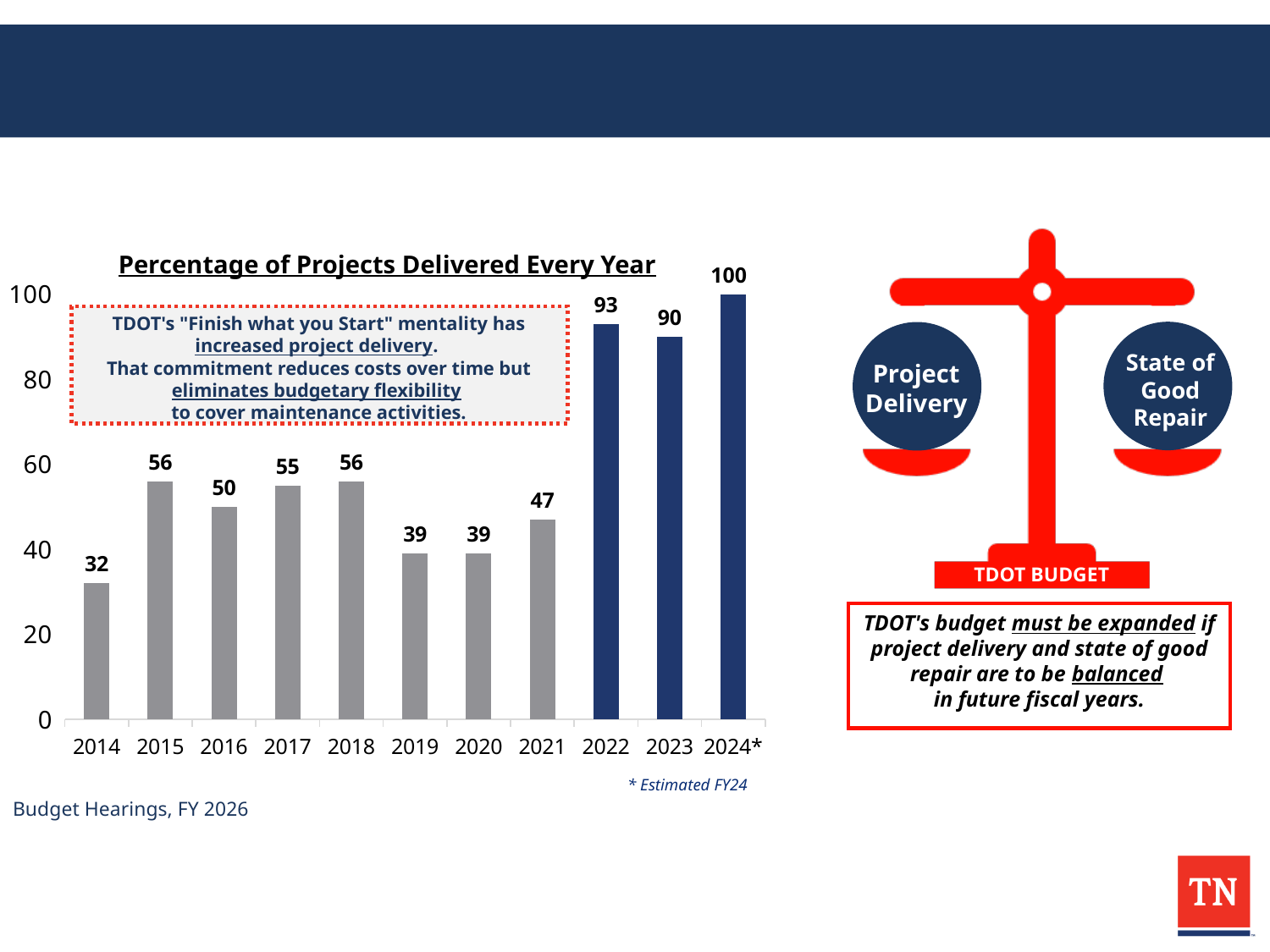
How many years are shown on the x axis of the chart? 11 What is the title of the chart? Percentage of Projects Delivered Every Year What is the value for 2021 in the chart? 47 Which is larger, the value for 2016 or the value for 2019? 2016 What is the difference between the values for 2023 and 2021? 43 Which year has the lowest value in the chart? 2014 Which year has the highest value in the chart? 2024* What is the value for 2014 in the chart? 32 What is the value for 2022 in the chart? 93 Is the value for 2018 greater or less than 40? greater What kind of chart is shown on the slide? Bar chart Do the values rise or fall from 2021 to 2024*? Rise